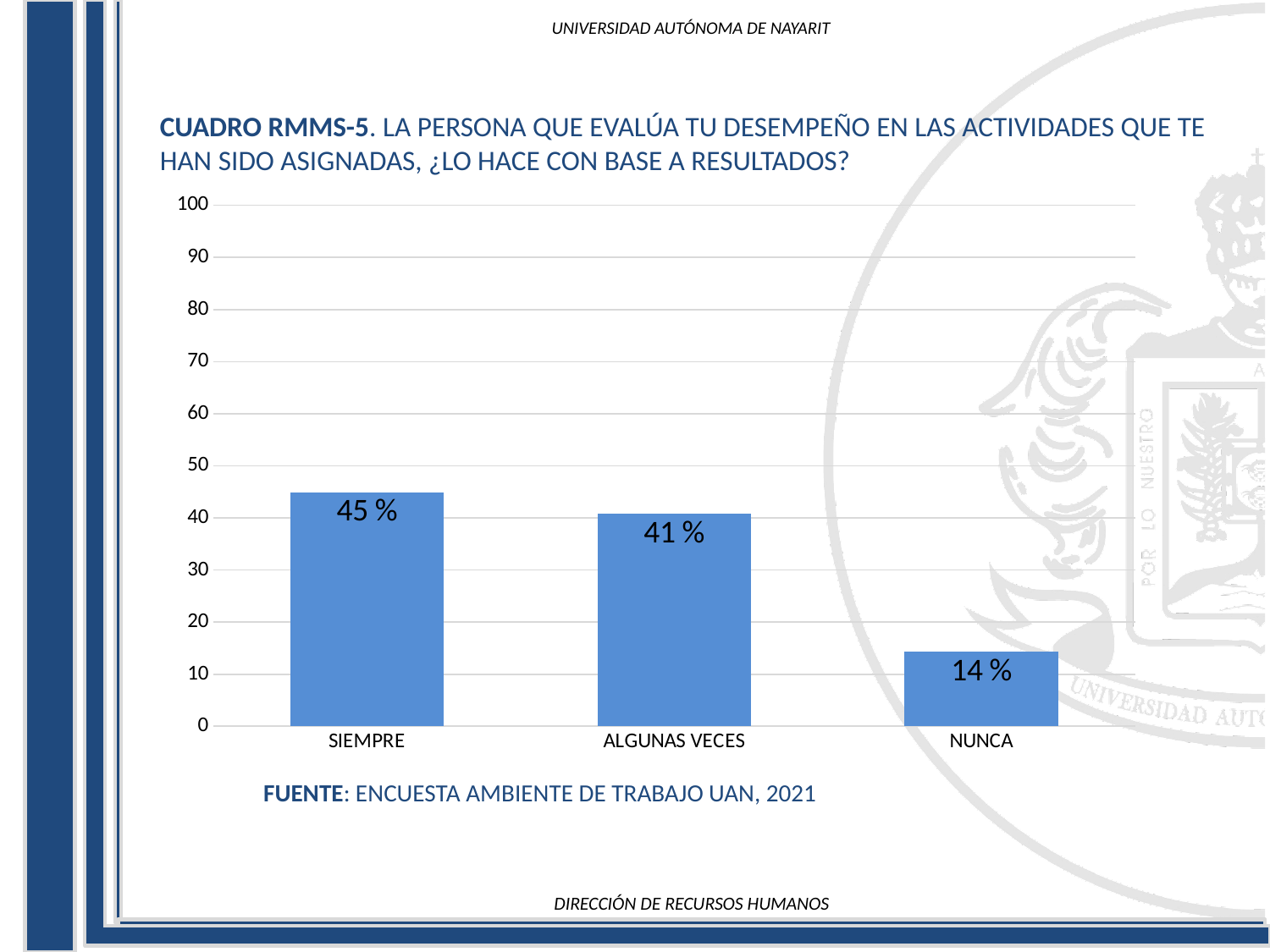
What is the value for SIEMPRE? 45 % Is the value for NUNCA greater or less than 20? less What kind of chart is shown on the slide? bar chart How many categories are shown on the x axis? 3 Which is larger, the value for ALGUNAS VECES or the value for NUNCA? ALGUNAS VECES What is the difference between the values for SIEMPRE and ALGUNAS VECES? 4 % What is the difference between the values for SIEMPRE and NUNCA? 31 % What is the value for ALGUNAS VECES? 41 % What source is cited below the chart? ENCUESTA AMBIENTE DE TRABAJO UAN, 2021 Which category has the lowest value? NUNCA Which category has the highest value? SIEMPRE What is the value for NUNCA? 14 %